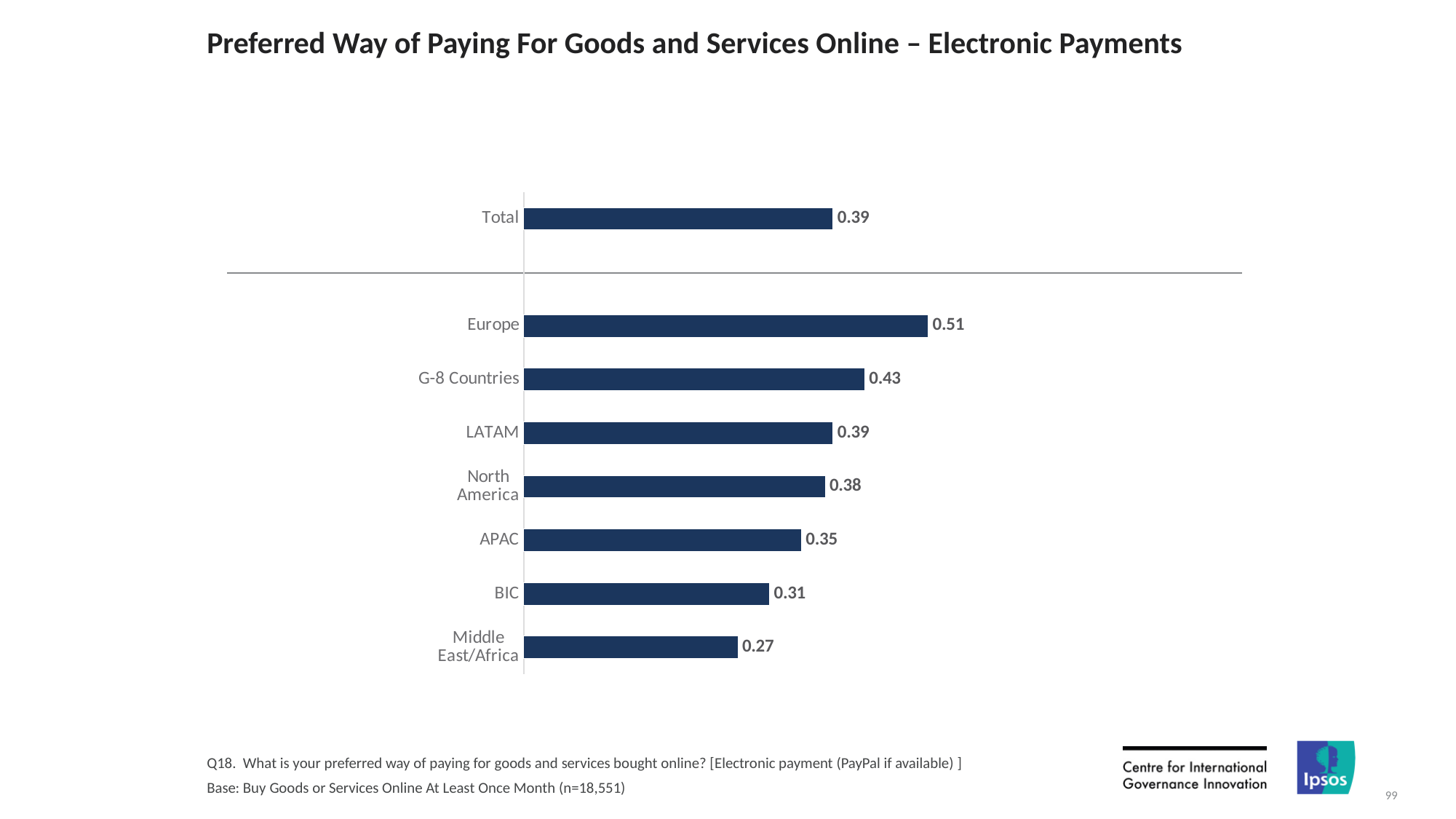
What is the value for Middle East/Africa? 0.27 What kind of chart is shown on the slide? Bar chart What is the difference between the values for BIC and Middle East/Africa? 0.04 How many bars are shown in the chart, including Total? 8 What is the value for APAC? 0.35 What is the value for Europe? 0.51 Which region has the highest value? Europe What is the title of the chart? Preferred Way of Paying For Goods and Services Online – Electronic Payments What is the difference between the values for Europe and G-8 Countries? 0.08 What is the value for Total? 0.39 Which region has the lowest value? Middle East/Africa Which is larger, the value for North America or the value for BIC? North America